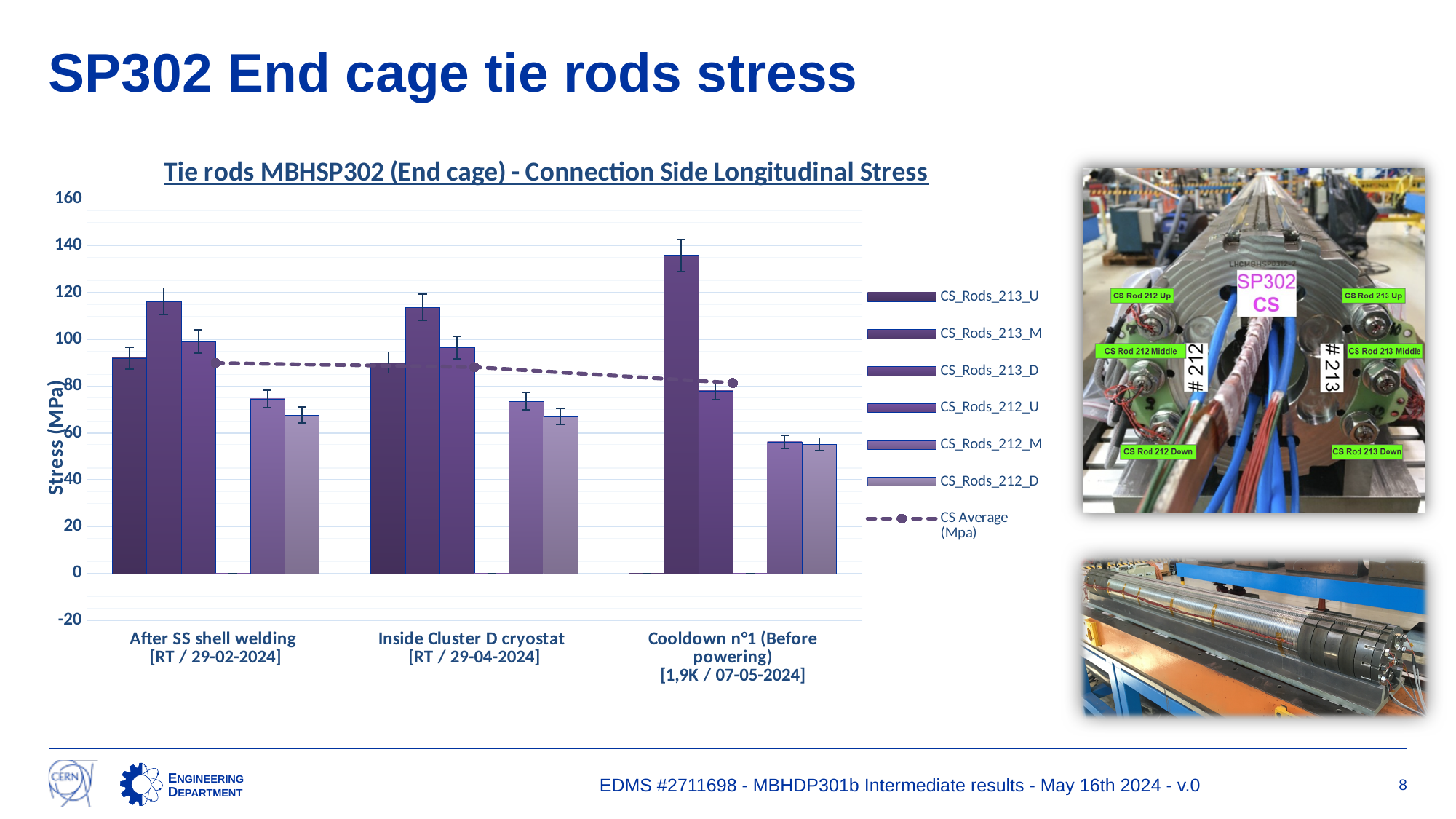
Is the value for CS_Rods_213_M at Cooldown n°1 (Before powering) greater or less than 120? greater In which measurement stage is the CS_Rods_212_M stress lowest? Cooldown n°1 (Before powering) In which measurement stage is the CS_Rods_213_M stress highest? Cooldown n°1 (Before powering) Is the value for CS_Rods_212_D at Cooldown n°1 (Before powering) greater or less than 60? less How many series does the legend of the tie rods stress chart list? 7 Does the CS Average line rise or fall from After SS shell welding to Cooldown n°1? fall At After SS shell welding, which is larger: CS_Rods_213_M or CS_Rods_213_U? CS_Rods_213_M Is the value for CS_Rods_213_U at After SS shell welding greater or less than 80? greater What is the label of the y axis of the tie rods stress chart? Stress (MPa) What kind of chart is used to show the tie rod stress values? bar chart How many measurement stages (categories) are shown on the x axis of the tie rods stress chart? 3